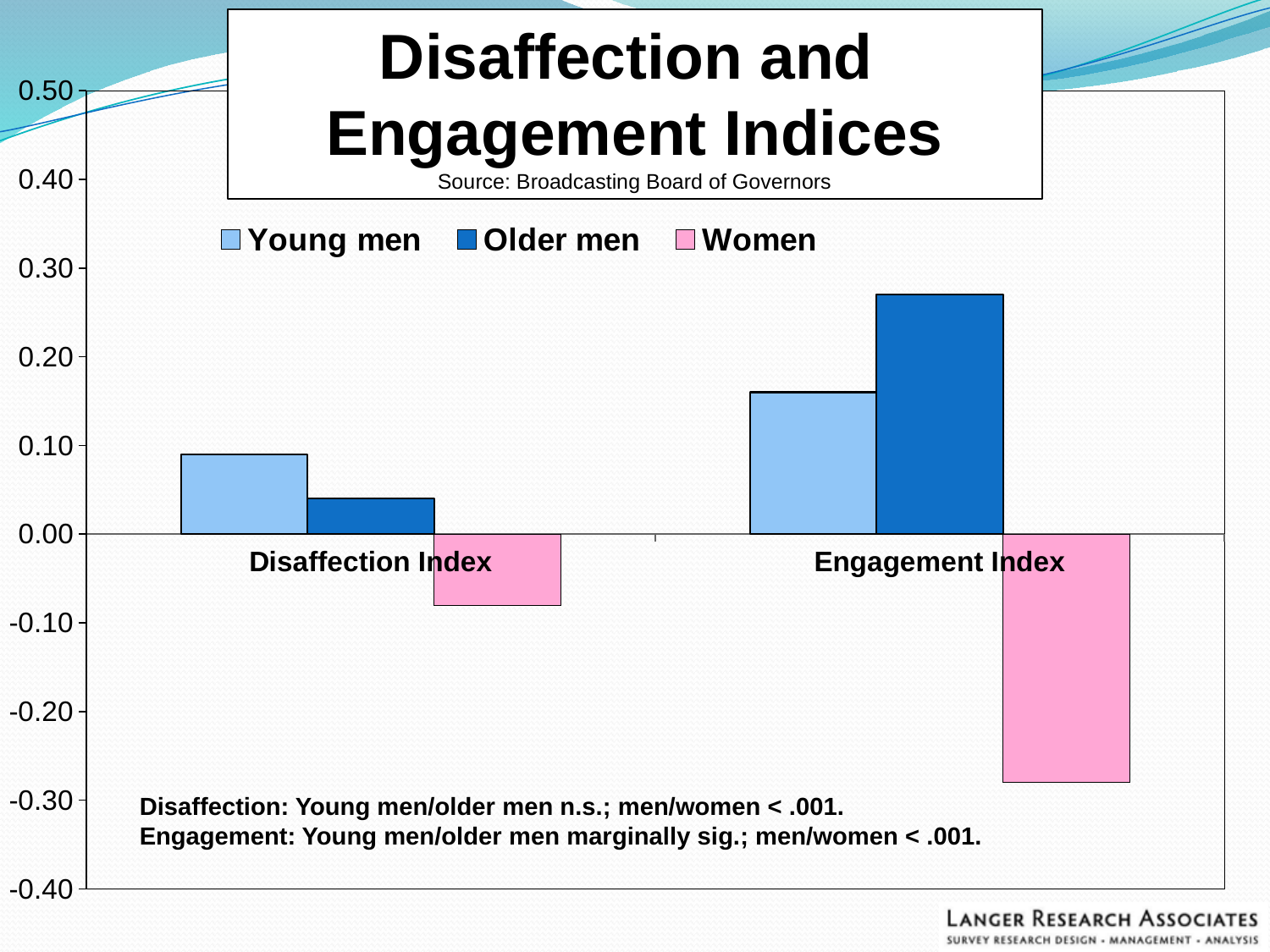
Which series has the highest value for the Engagement Index? Older men Is the value for Older men on the Engagement Index greater or less than 0.20? greater How many categories are shown on the x axis? 2 Which is larger: the Young men value for the Disaffection Index or the Young men value for the Engagement Index? Engagement Index Is the value for Women on the Engagement Index greater or less than -0.20? less Which series has the lowest value for the Engagement Index? Women What kind of chart is shown on the slide? bar chart How many series does the legend list? 3 Is the value for Young men on the Disaffection Index greater or less than 0.10? less Which series has the highest value for the Disaffection Index? Young men What is the source cited under the chart title? Broadcasting Board of Governors Which series has the lowest value for the Disaffection Index? Women